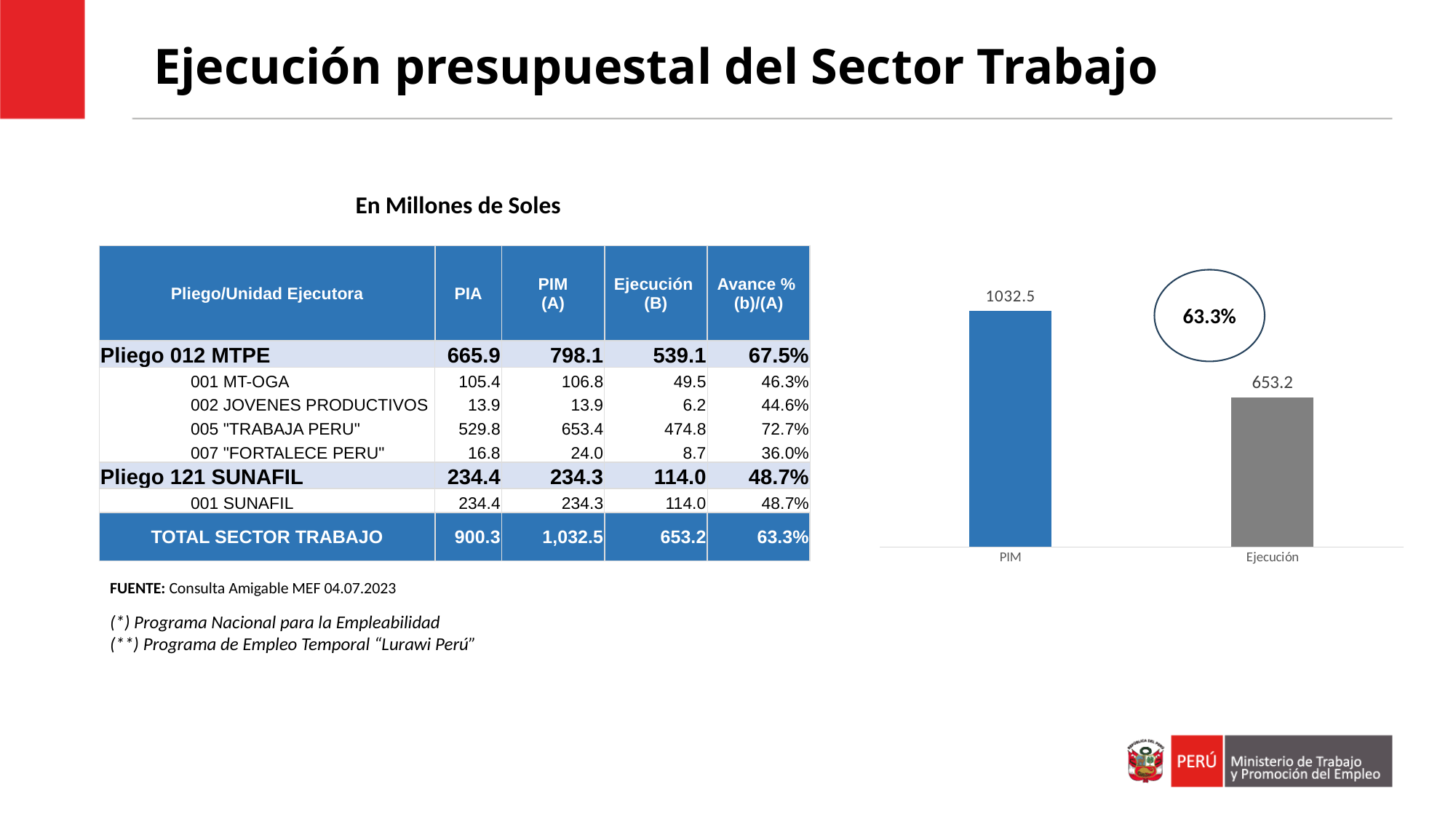
How many bars are plotted in the chart? 2 Which bar in the chart is the lowest? Ejecución Do the values in the chart rise or fall from PIM to Ejecución? Fall What kind of chart is shown on the right of the slide? Bar chart What colour is the Ejecución bar in the chart? Grey What percentage is shown in the circle next to the chart? 63.3% Which is larger in the chart, PIM or Ejecución? PIM What is the value of the Ejecución bar in the chart? 653.2 Which bar in the chart is the highest? PIM What is the difference between the PIM bar and the Ejecución bar in the chart? 379.3 What is the value of the PIM bar in the chart? 1032.5